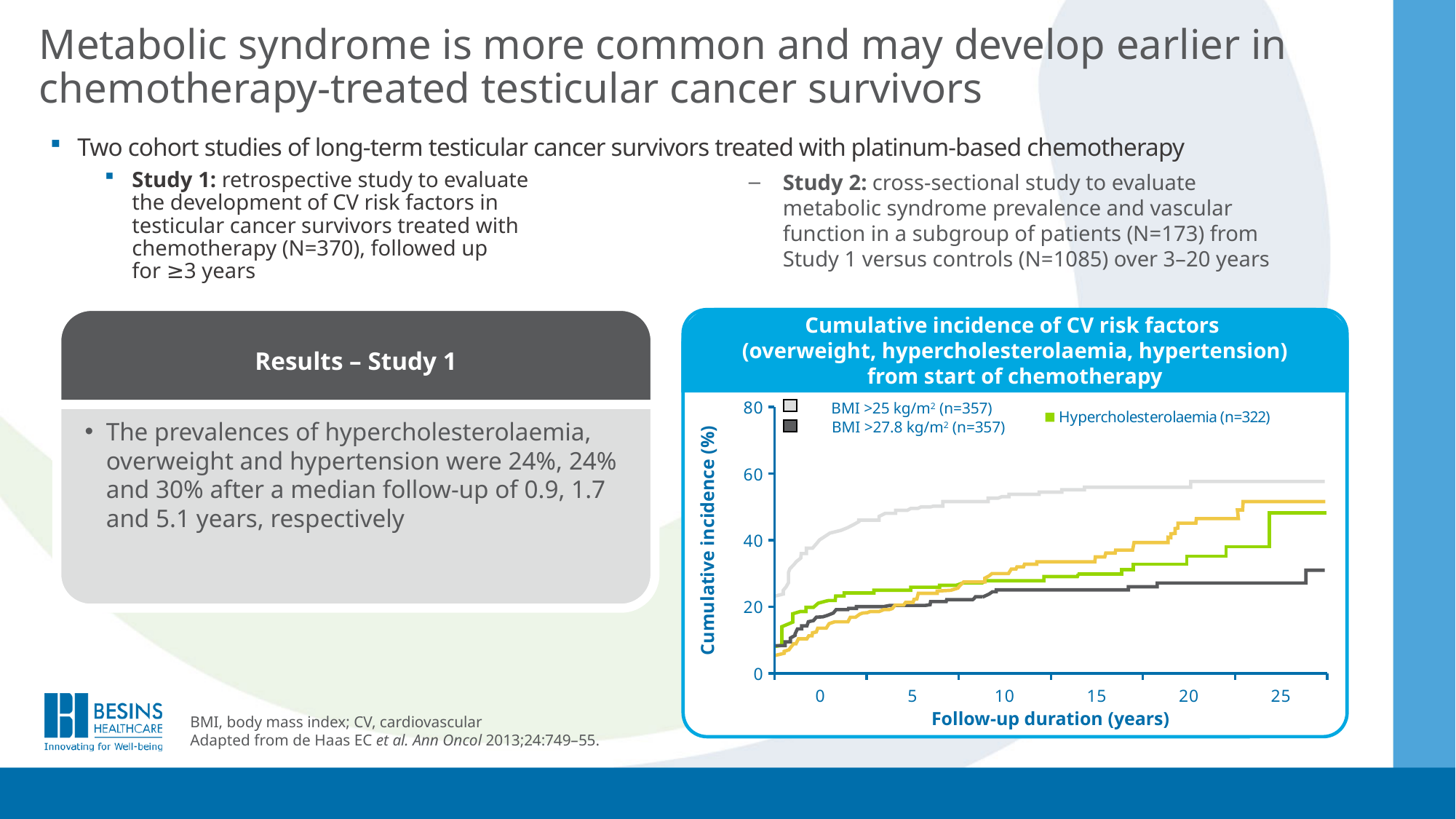
How many series does the chart legend list? 3 Is the cumulative incidence for BMI >27.8 kg/m² at 25 years greater or less than 40? less Is the cumulative incidence for BMI >25 kg/m² at 25 years greater or less than 40? greater Do the cumulative incidence curves rise or fall as follow-up duration increases? Rise Which series has the lowest cumulative incidence at 25 years of follow-up? BMI >27.8 kg/m² (n=357) What kind of chart is shown on the slide? Line chart What is the label of the y axis of the chart? Cumulative incidence (%) Which series has the highest cumulative incidence at 25 years of follow-up? BMI >25 kg/m² (n=357) Is the cumulative incidence for Hypercholesterolaemia at 25 years greater or less than 40? greater What is the title of the chart? Cumulative incidence of CV risk factors (overweight, hypercholesterolaemia, hypertension) from start of chemotherapy At 25 years of follow-up, which is larger: the cumulative incidence for BMI >25 kg/m² or for BMI >27.8 kg/m²? BMI >25 kg/m²